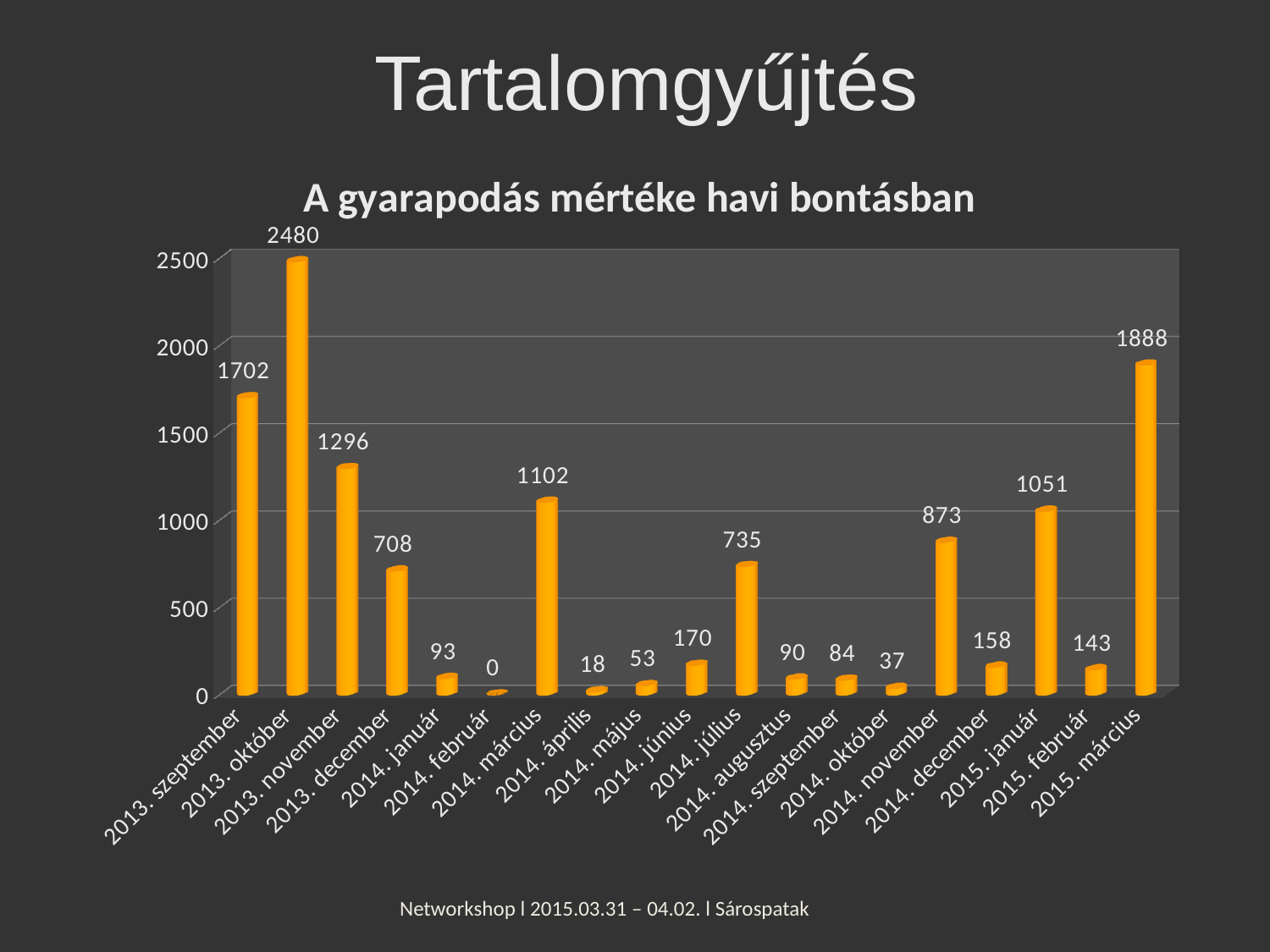
How many months are shown on the x axis? 19 What is the difference between the values for 2015. március and 2015. február? 1745 What kind of chart is shown on the slide? bar chart Which is larger, the value for 2014. július or the value for 2014. november? 2014. november What is the value for 2015. március? 1888 Which month has the highest value? 2013. október What is the title of the chart? A gyarapodás mértéke havi bontásban What is the value for 2014. március? 1102 What is the value for 2013. október? 2480 Which month has the lowest value? 2014. február Is the value for 2015. január greater or less than 1000? greater What is the difference between the values for 2013. október and 2013. szeptember? 778